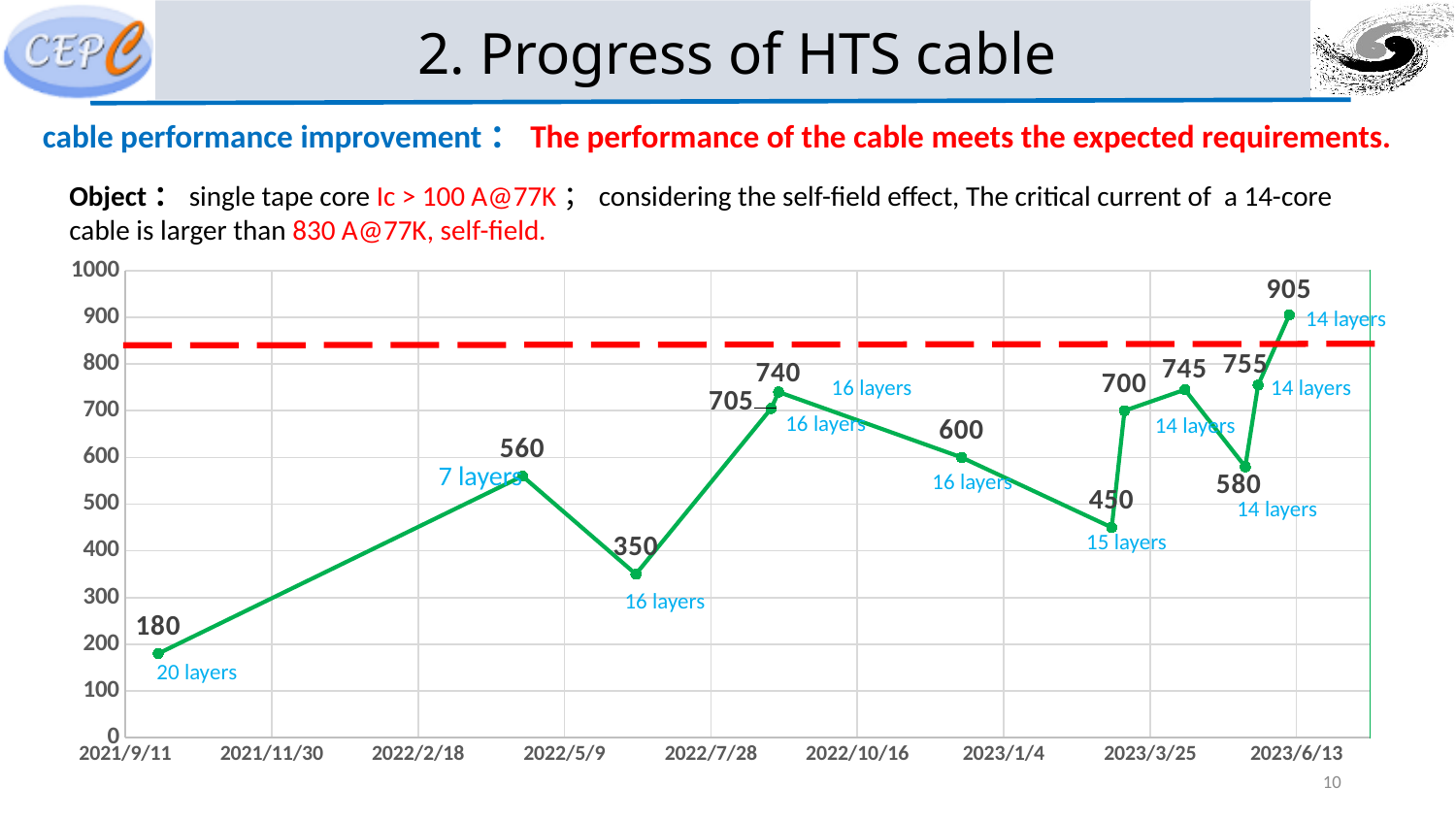
What is the lowest value plotted on the chart? 180 What is the value of the data point annotated "7 layers"? 560 What is the value of the data point annotated "20 layers"? 180 What kind of chart is shown on the slide? line chart What is the value of the data point annotated "15 layers"? 450 What colour is the horizontal dashed line on the chart? red What is the highest value plotted on the chart? 905 Overall, do the values rise or fall from the first point to the last point along the x axis? rise Which is larger, the point labelled 740 or the point labelled 600? 740 What is the difference between the highest value (905) and the lowest value (180)? 725 Is the last data point on the chart greater or less than 800? greater How many data points are plotted on the line? 12